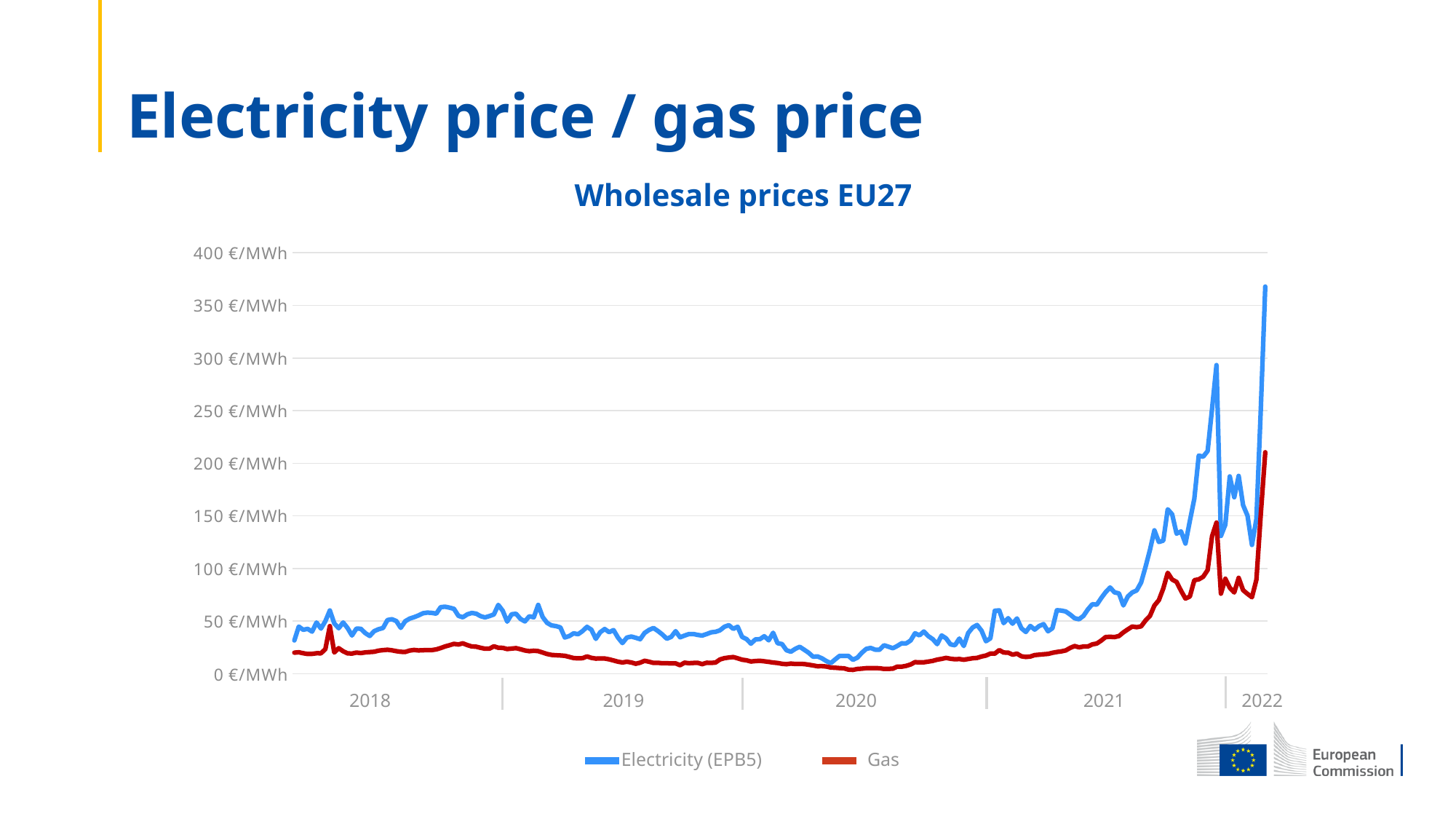
Which series is drawn in red? Gas What is the title of the chart? Wholesale prices EU27 Which series has the lower value at the start of 2018, Electricity (EPB5) or Gas? Gas Is the Electricity (EPB5) price in mid-2020 greater or less than 100 €/MWh? less Do the Electricity (EPB5) prices rise or fall from 2020 to 2022? rise Which series reaches the higher peak value, Electricity (EPB5) or Gas? Electricity (EPB5) Is the peak value of the Electricity (EPB5) series in 2022 greater or less than 350 €/MWh? greater What is the highest value shown on the y axis? 400 €/MWh Is the peak value of the Gas series in 2022 greater or less than 250 €/MWh? less How many series does the legend list? 2 What kind of chart is shown on the slide? line chart